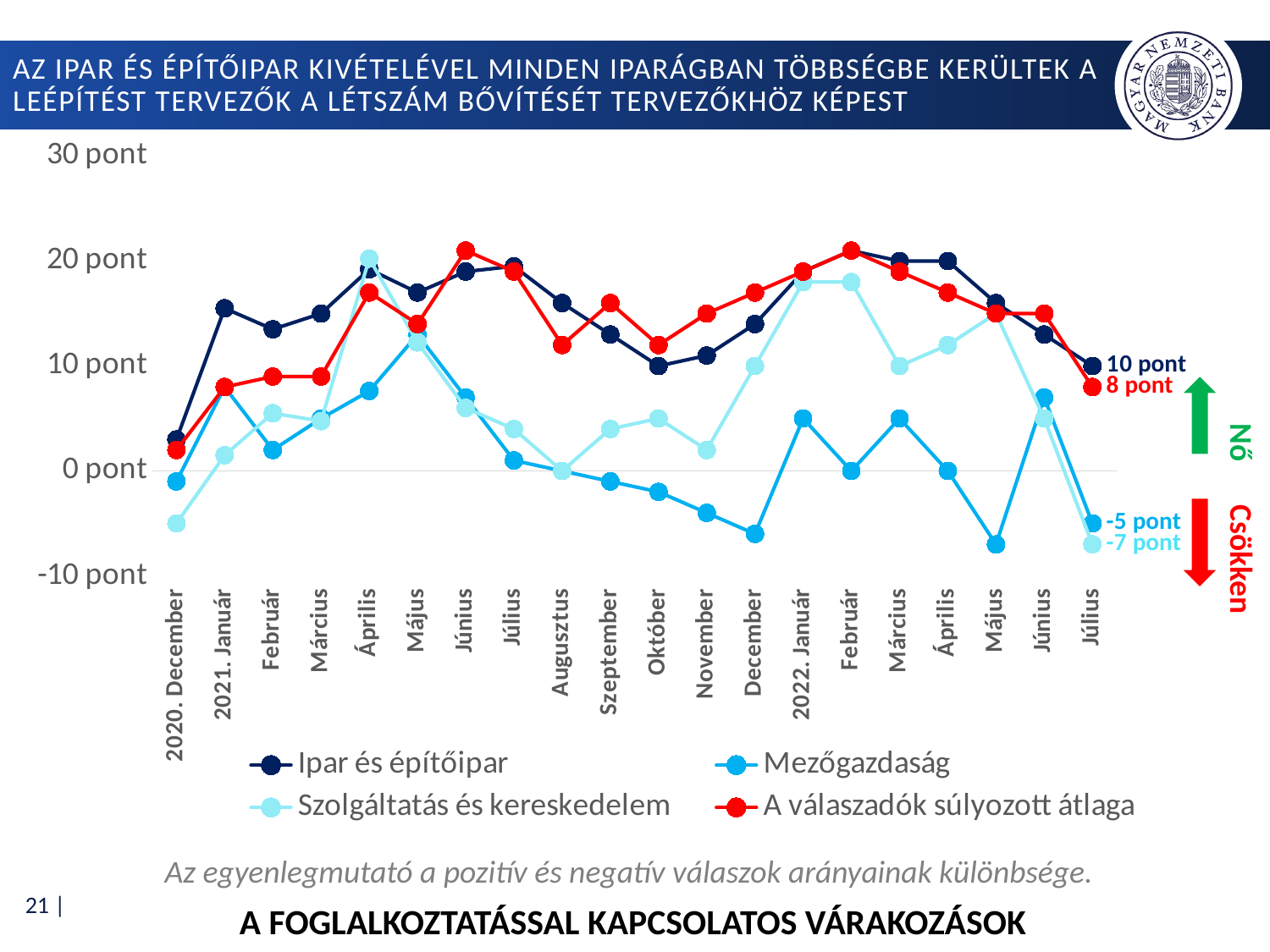
What is the value for Szolgáltatás és kereskedelem in 2022 Július? -7 pont What is the difference between Ipar és építőipar and Mezőgazdaság in 2022 Július? 15 pont What is the value for A válaszadók súlyozott átlaga in 2022 Július? 8 pont Is the value for Ipar és építőipar in 2021. Január greater or less than 10 pont? greater How many series does the legend list? 4 Is the value for Szolgáltatás és kereskedelem in 2020. December greater or less than 0 pont? less How many months are shown on the x axis? 20 What kind of chart is shown on the slide? line chart In 2022 Július, which is larger: Ipar és építőipar or A válaszadók súlyozott átlaga? Ipar és építőipar What is the value for Mezőgazdaság in 2022 Július? -5 pont Which series has the lowest value in 2022 Július? Szolgáltatás és kereskedelem What is the value for Ipar és építőipar in 2022 Július? 10 pont